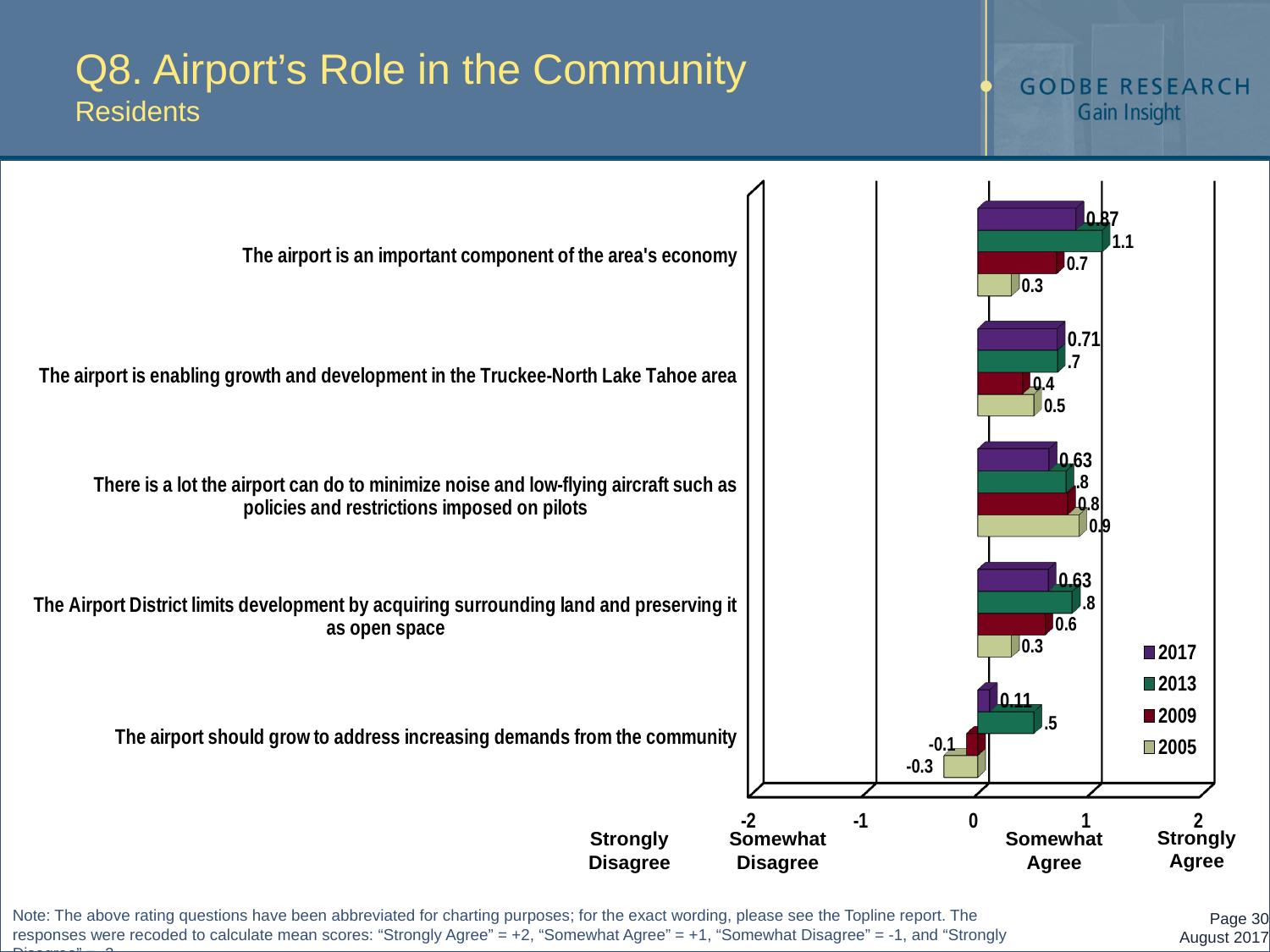
How many series does the legend list? 4 What is the 2005 mean score for "The airport should grow to address increasing demands from the community"? -0.3 What label does the x axis show at the value 2? Strongly Agree For "The airport is an important component of the area's economy", what is the difference between the 2013 and 2005 mean scores? 0.8 Is the 2013 mean score for "The airport is an important component of the area's economy" greater or less than 1? greater Which statement has the highest 2017 mean score? The airport is an important component of the area's economy How many statements (categories) are plotted in the chart? 5 What kind of chart is shown on the slide? Bar chart For "The airport is enabling growth and development in the Truckee-North Lake Tahoe area", which year has the larger mean score, 2009 or 2005? 2005 Which statement has the lowest 2017 mean score? The airport should grow to address increasing demands from the community What is the 2013 mean score for "The airport is an important component of the area's economy"? 1.1 What is the 2017 mean score for "The airport is enabling growth and development in the Truckee-North Lake Tahoe area"? 0.71